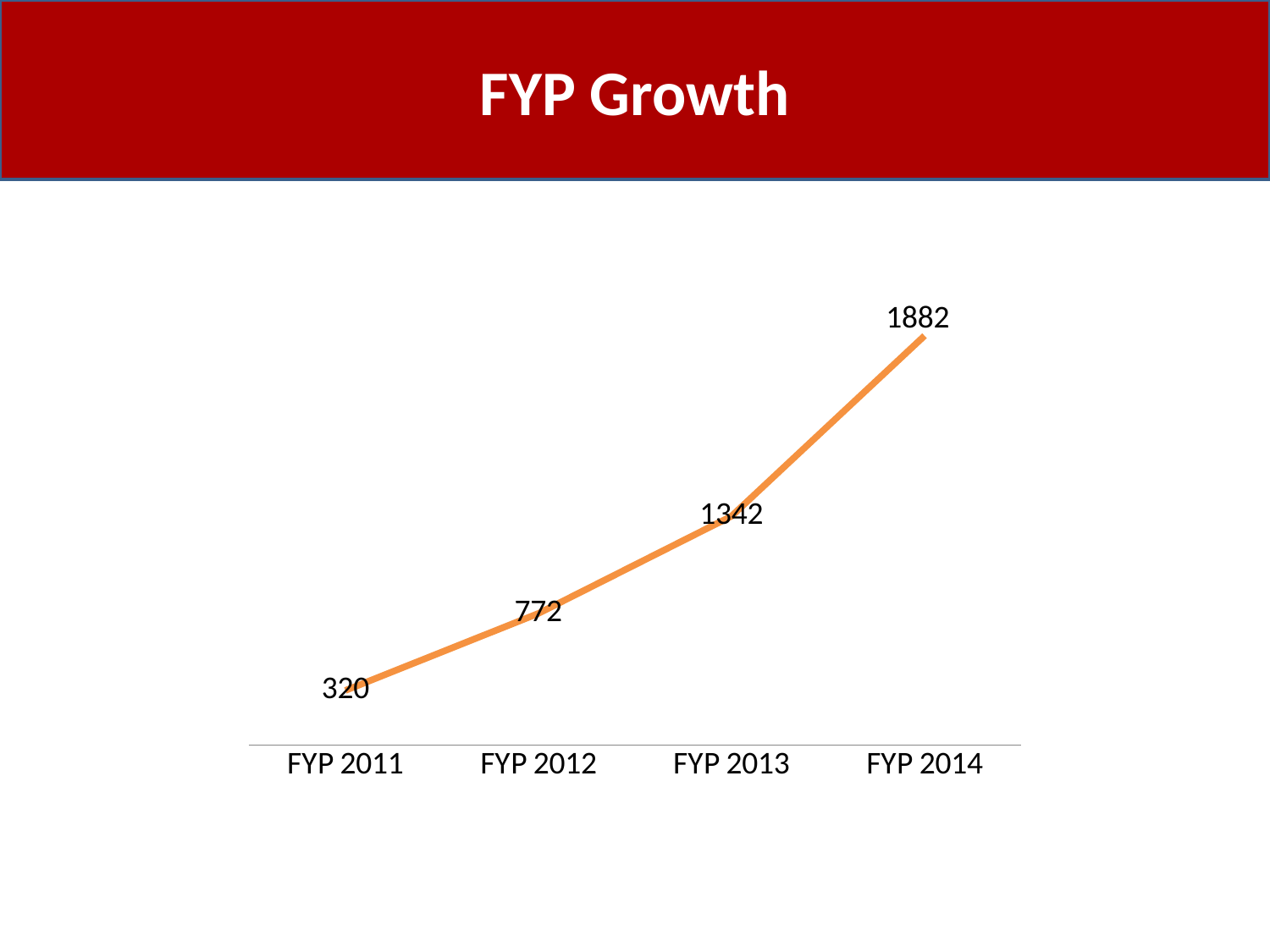
Which is larger, the value for FYP 2013 or the value for FYP 2012? FYP 2013 How many data points are plotted on the chart? 4 Which year has the highest value? FYP 2014 What is the value for FYP 2012? 772 What is the difference between the values for FYP 2014 and FYP 2013? 540 What is the value for FYP 2014? 1882 Do the values rise or fall from FYP 2011 to FYP 2014? rise What kind of chart is shown on the slide? line chart Which year has the lowest value? FYP 2011 What is the value for FYP 2011? 320 What is the difference between the values for FYP 2012 and FYP 2011? 452 What is the value for FYP 2013? 1342